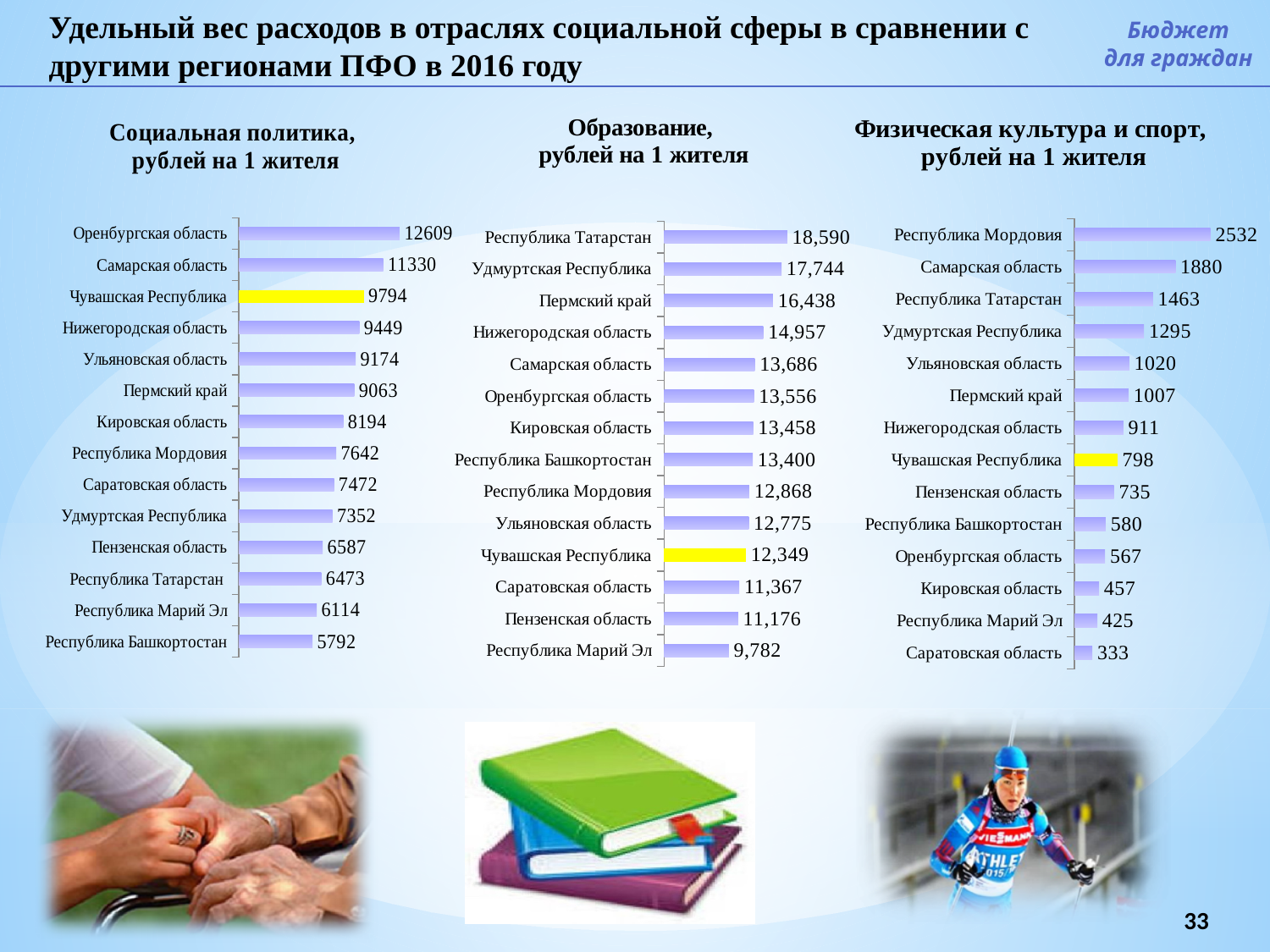
In the 'Образование, рублей на 1 жителя' chart, which region has the lowest value? Республика Марий Эл In the 'Образование, рублей на 1 жителя' chart, how many regions are shown? 14 In the 'Социальная политика, рублей на 1 жителя' chart, which region has the highest value? Оренбургская область In the 'Образование, рублей на 1 жителя' chart, which is larger: Пермский край or Нижегородская область? Пермский край In the 'Физическая культура и спорт, рублей на 1 жителя' chart, which region has the highest value? Республика Мордовия In the 'Социальная политика, рублей на 1 жителя' chart, what is the difference between Оренбургская область and Самарская область? 1279 In the 'Физическая культура и спорт, рублей на 1 жителя' chart, what is the value for Чувашская Республика? 798 In the 'Социальная политика, рублей на 1 жителя' chart, which region has the lowest value? Республика Башкортостан In the 'Образование, рублей на 1 жителя' chart, what is the value for Республика Татарстан? 18,590 What type of chart is used for the 'Социальная политика, рублей на 1 жителя' chart? Bar chart In the 'Социальная политика, рублей на 1 жителя' chart, what is the value for Чувашская Республика? 9794 In the 'Физическая культура и спорт, рублей на 1 жителя' chart, what is the difference between Республика Мордовия and Саратовская область? 2199